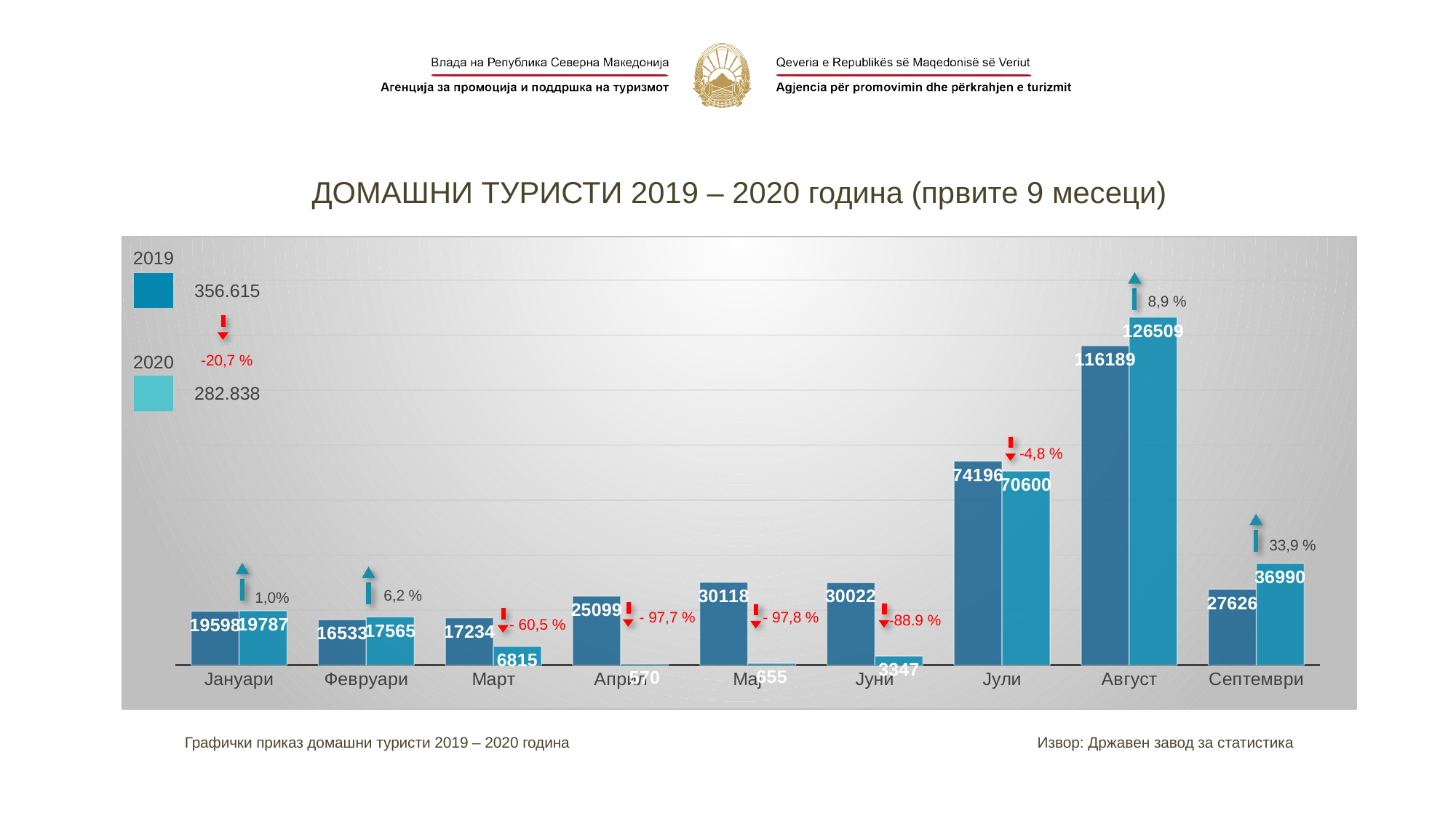
Which is larger for Јули: the 2019 value or the 2020 value? 2019 Which month has the highest 2020 value? Август What percentage change is shown for Март (March)? - 60,5 % What is the difference between the 2020 and 2019 values for Август? 10320 What total is shown in the legend for 2019? 356.615 What is the 2019 value for Август (August)? 116189 How many months are shown on the x axis? 9 What is the 2020 value for Април (April)? 570 How many series does the legend list? 2 Which month has the lowest 2020 value? Април What is the 2020 value for Септември (September)? 36990 What kind of chart is shown on the slide? bar chart